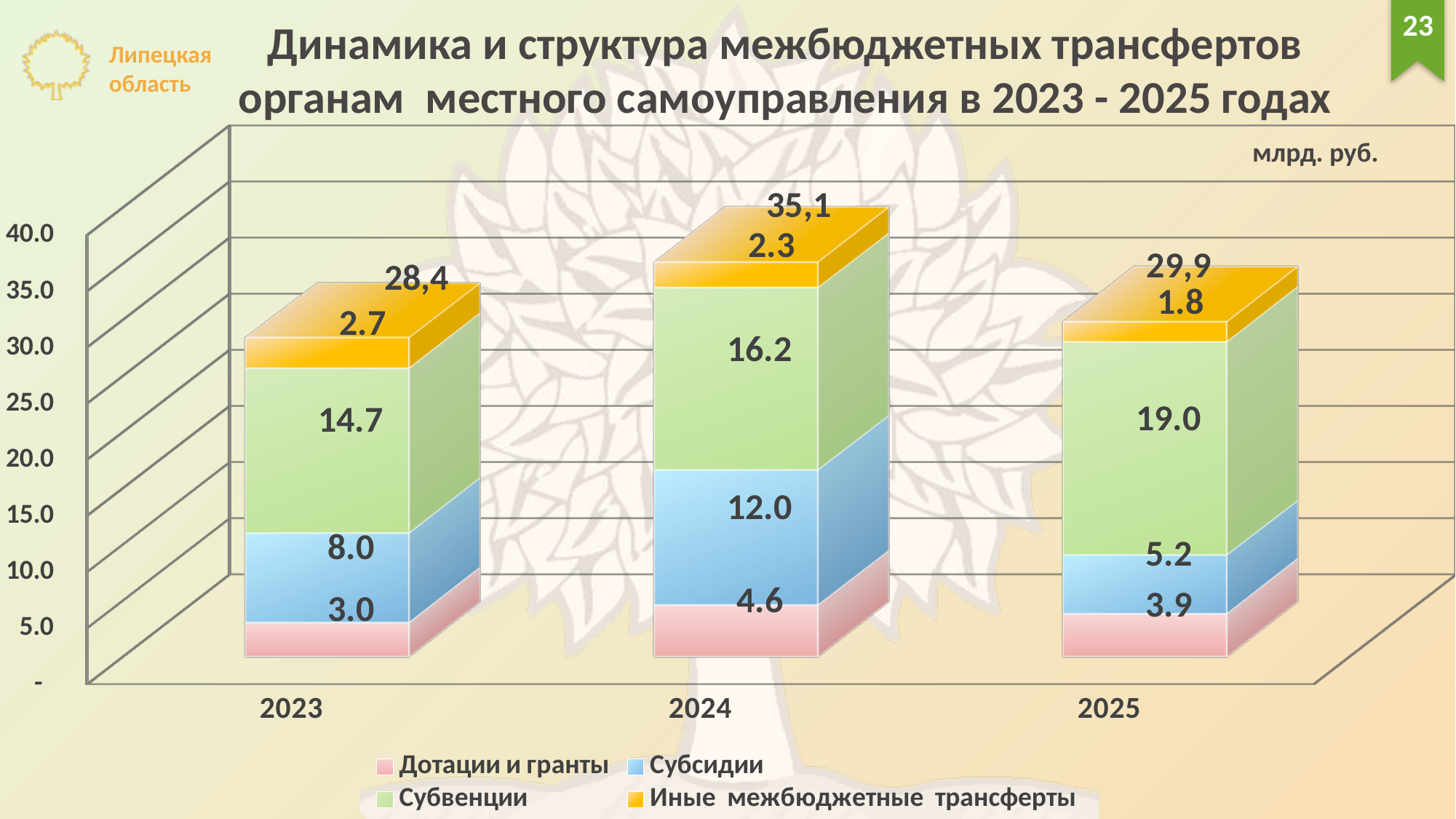
What is the value of Субсидии for 2023? 8.0 What is the total of the stacked bar for 2024? 35,1 Which year has the highest total of interbudget transfers? 2024 What is the value of Дотации и гранты for 2025? 3.9 How many series does the legend list? 4 What is the value of Субвенции for 2024? 16.2 What type of chart is shown on the slide? Stacked bar chart What is the difference between the Субсидии values for 2024 and 2025? 6.8 Which year has the lowest value for Иные межбюджетные трансферты? 2025 How many years (categories) are shown on the x axis? 3 Which is larger: Субвенции in 2025 or Субвенции in 2023? Субвенции in 2025 What unit of measurement is indicated on the chart? млрд. руб.